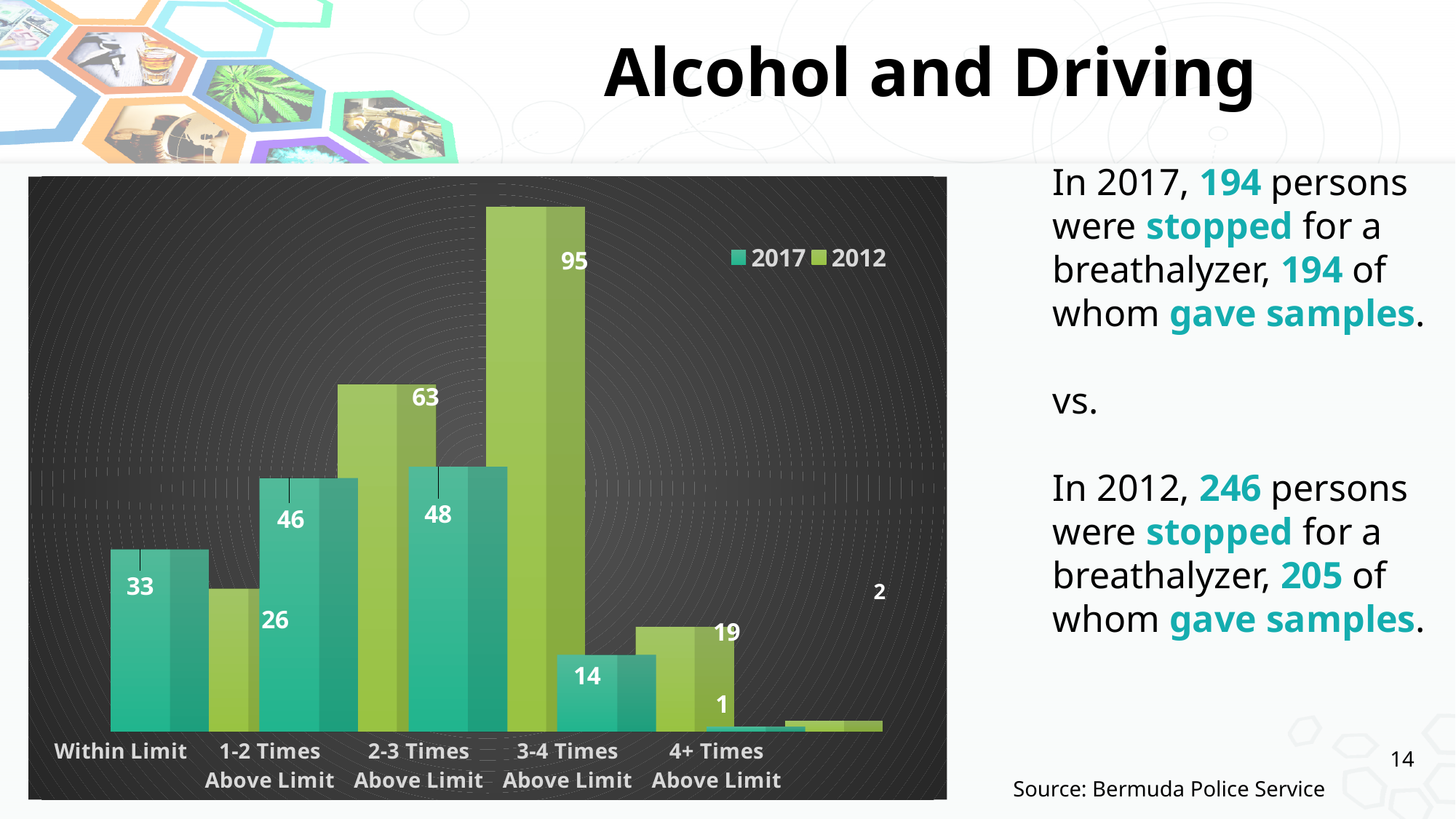
What is the 2017 value for 3-4 Times Above Limit? 14 Which category has the highest 2012 value? 2-3 Times Above Limit Which is larger for Within Limit, the 2017 value or the 2012 value? 2017 What is the 2012 value for 2-3 Times Above Limit? 95 Which category has the lowest 2017 value? 4+ Times Above Limit How many series does the legend list? 2 What is the 2012 value for 1-2 Times Above Limit? 63 How many categories are shown on the x axis? 5 What kind of chart is shown on the slide? Bar chart What is the 2017 value for Within Limit? 33 What is the total of the 2017 and 2012 values for 4+ Times Above Limit? 3 What is the difference between the 2012 and 2017 values for 2-3 Times Above Limit? 47